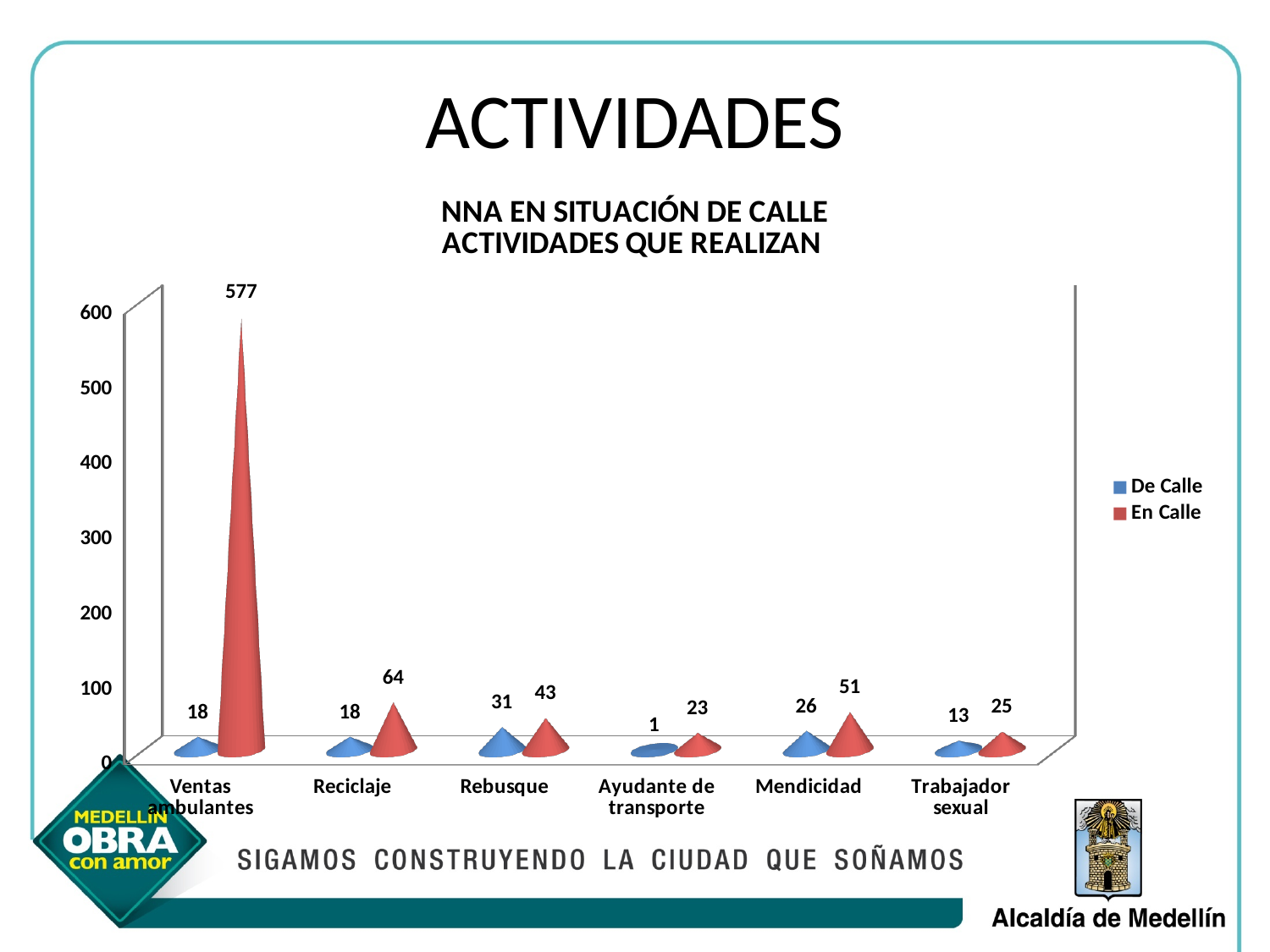
What is the En Calle value for Ventas ambulantes? 577 How many series does the legend list? 2 What kind of chart is shown on the slide? Bar chart Which category has the lowest De Calle value? Ayudante de transporte Which is larger for Trabajador sexual, the De Calle value or the En Calle value? En Calle What is the title of the chart? NNA EN SITUACIÓN DE CALLE ACTIVIDADES QUE REALIZAN What is the De Calle value for Ayudante de transporte? 1 How many activity categories are shown on the x axis? 6 What is the difference between the En Calle and De Calle values for Reciclaje? 46 Which category has the highest En Calle value? Ventas ambulantes What is the En Calle value for Mendicidad? 51 What is the De Calle value for Rebusque? 31